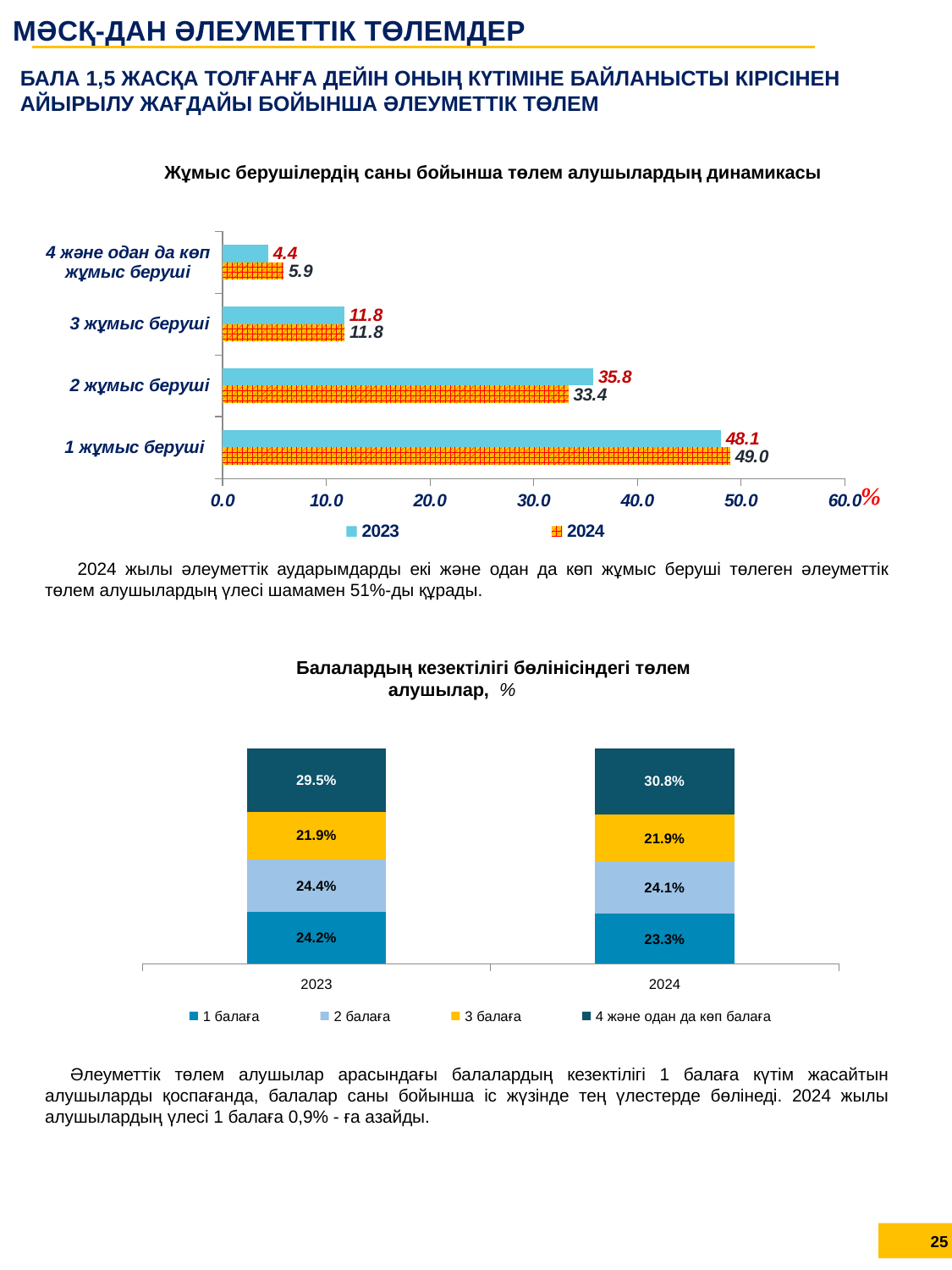
In the chart 'Балалардың кезектілігі бөлінісіндегі төлем алушылар, %', what is the share of '1 балаға' in 2023? 24.2% In the chart 'Балалардың кезектілігі бөлінісіндегі төлем алушылар, %', what is the difference between the '4 және одан да көп балаға' shares in 2024 and 2023? 1.3% In the chart 'Жұмыс берушілердің саны бойынша төлем алушылардың динамикасы', what is the difference between the 2023 and 2024 values for '2 жұмыс беруші'? 2.4 In the chart 'Балалардың кезектілігі бөлінісіндегі төлем алушылар, %', how many series does the legend list? 4 In the chart 'Жұмыс берушілердің саны бойынша төлем алушылардың динамикасы', what is the 2024 value for '1 жұмыс беруші'? 49.0 In the chart 'Балалардың кезектілігі бөлінісіндегі төлем алушылар, %', is the '1 балаға' share larger in 2023 or 2024? 2023 In the chart 'Жұмыс берушілердің саны бойынша төлем алушылардың динамикасы', how many series does the legend list? 2 In the chart 'Жұмыс берушілердің саны бойынша төлем алушылардың динамикасы', which category has the lowest 2024 value? 4 және одан да көп жұмыс беруші In the chart 'Жұмыс берушілердің саны бойынша төлем алушылардың динамикасы', which category has the highest 2023 value? 1 жұмыс беруші In the chart 'Жұмыс берушілердің саны бойынша төлем алушылардың динамикасы', what is the 2023 value for '4 және одан да көп жұмыс беруші'? 4.4 In the chart 'Балалардың кезектілігі бөлінісіндегі төлем алушылар, %', what is the share of '4 және одан да көп балаға' in 2024? 30.8% What kind of chart is 'Жұмыс берушілердің саны бойынша төлем алушылардың динамикасы'? Bar chart